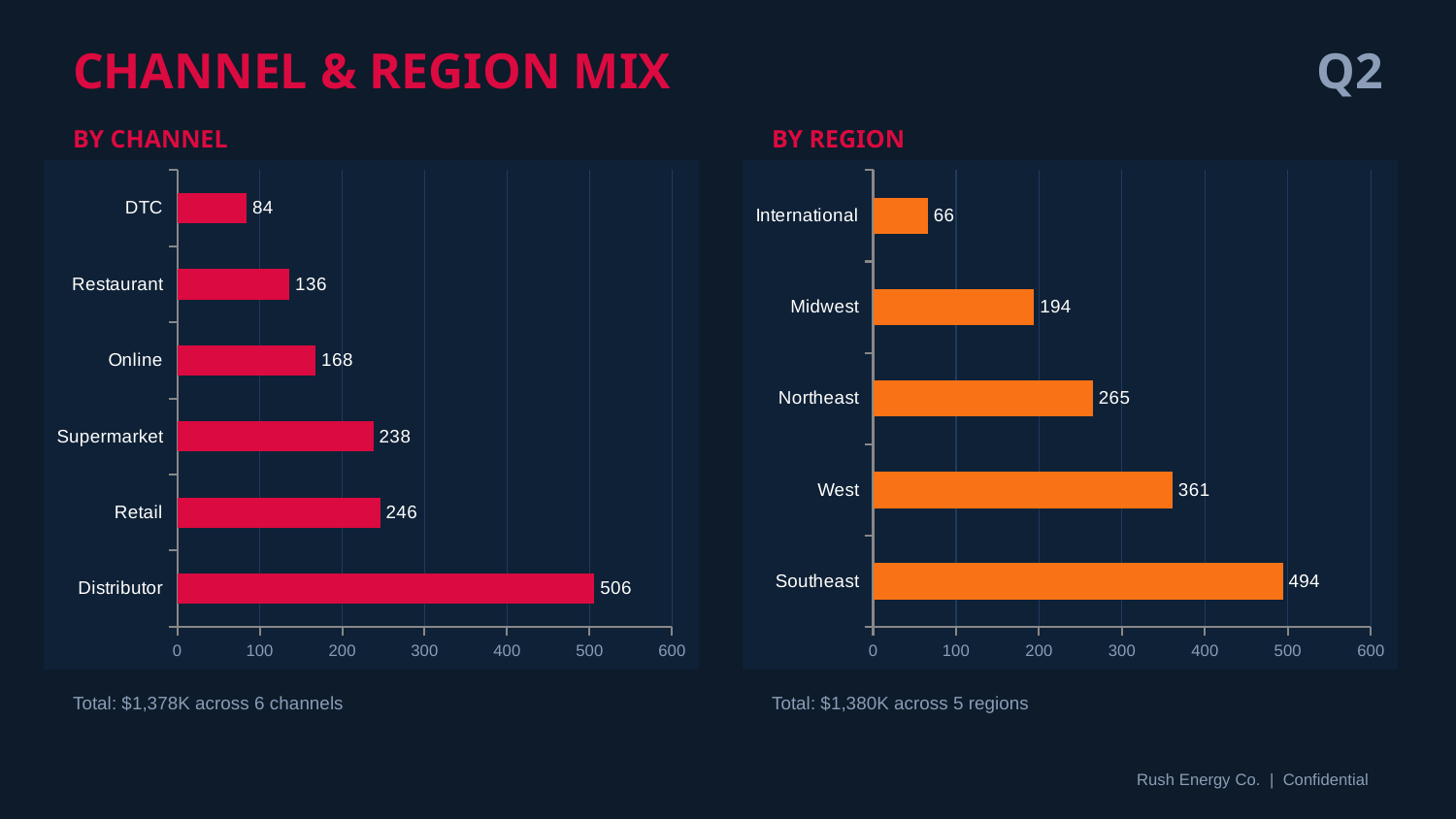
How many channels are shown in the By Channel chart? 6 In the By Channel chart, what is the value for Online? 168 How many regions are shown in the By Region chart? 5 In the By Channel chart, which channel has the highest value? Distributor In the By Region chart, is the value for Northeast greater or less than 200? greater What type of chart is the By Region chart? Bar chart In the By Region chart, what is the difference between Southeast and West? 133 In the By Region chart, which region has the lowest value? International What colour are the bars in the By Channel chart? Red In the By Channel chart, what is the difference between Distributor and Retail? 260 In the By Region chart, what is the value for Midwest? 194 In the By Channel chart, which is larger, Supermarket or Restaurant? Supermarket